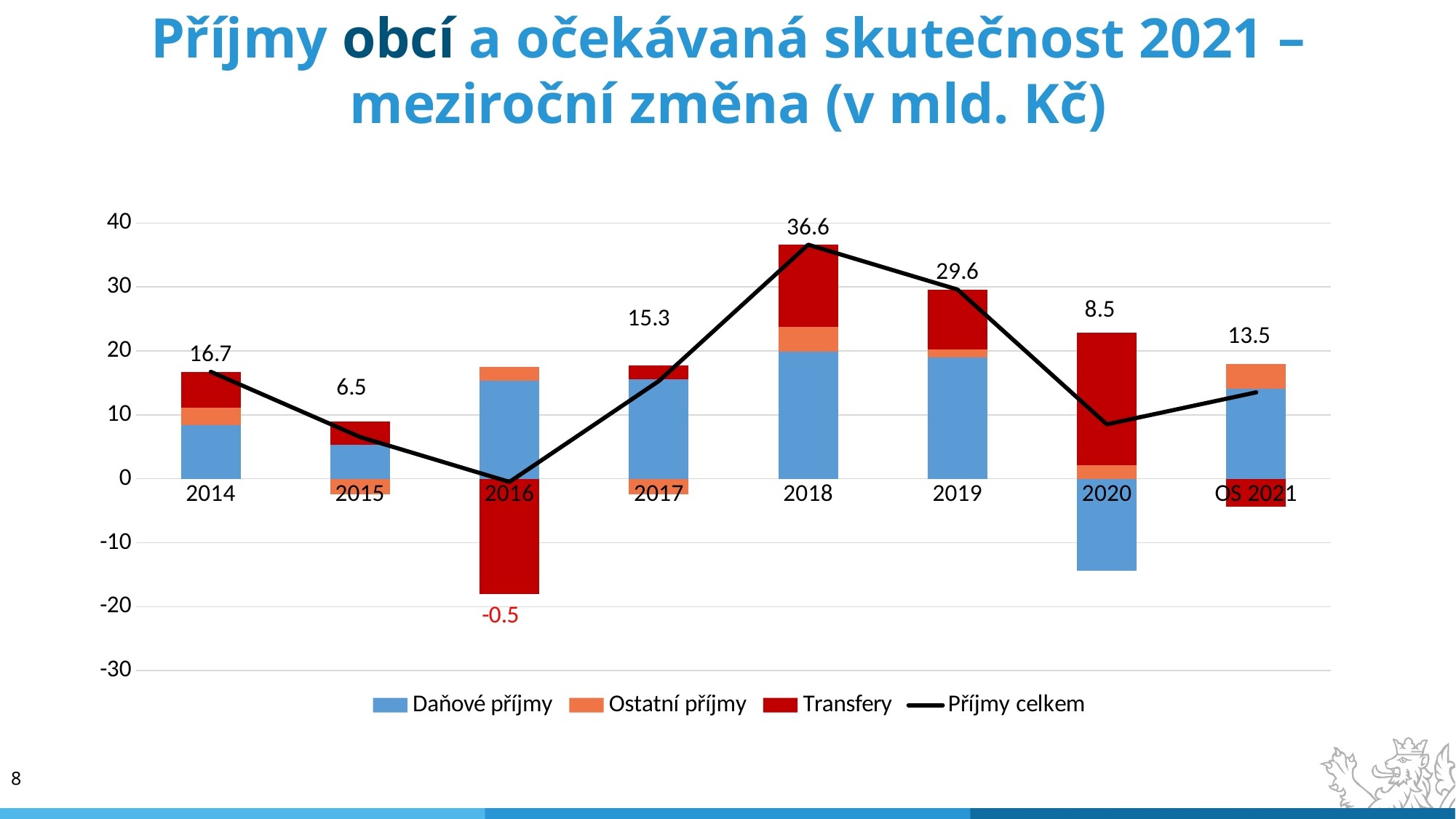
Is the Daňové příjmy value for 2018 greater or less than 10? greater In which year is Příjmy celkem lowest? 2016 Is the Transfery value for 2016 greater or less than -10? less Does Příjmy celkem rise or fall from 2019 to 2020? fall What is the value of Příjmy celkem for 2016? -0.5 What is the value of Příjmy celkem for 2018? 36.6 In which year is Příjmy celkem highest? 2018 What is the difference between Příjmy celkem in 2018 and 2019? 7.0 How many series does the legend list? 4 Which year has the larger Příjmy celkem value, 2014 or 2020? 2014 What is the value of Příjmy celkem for OS 2021? 13.5 How many categories are shown on the x axis? 8